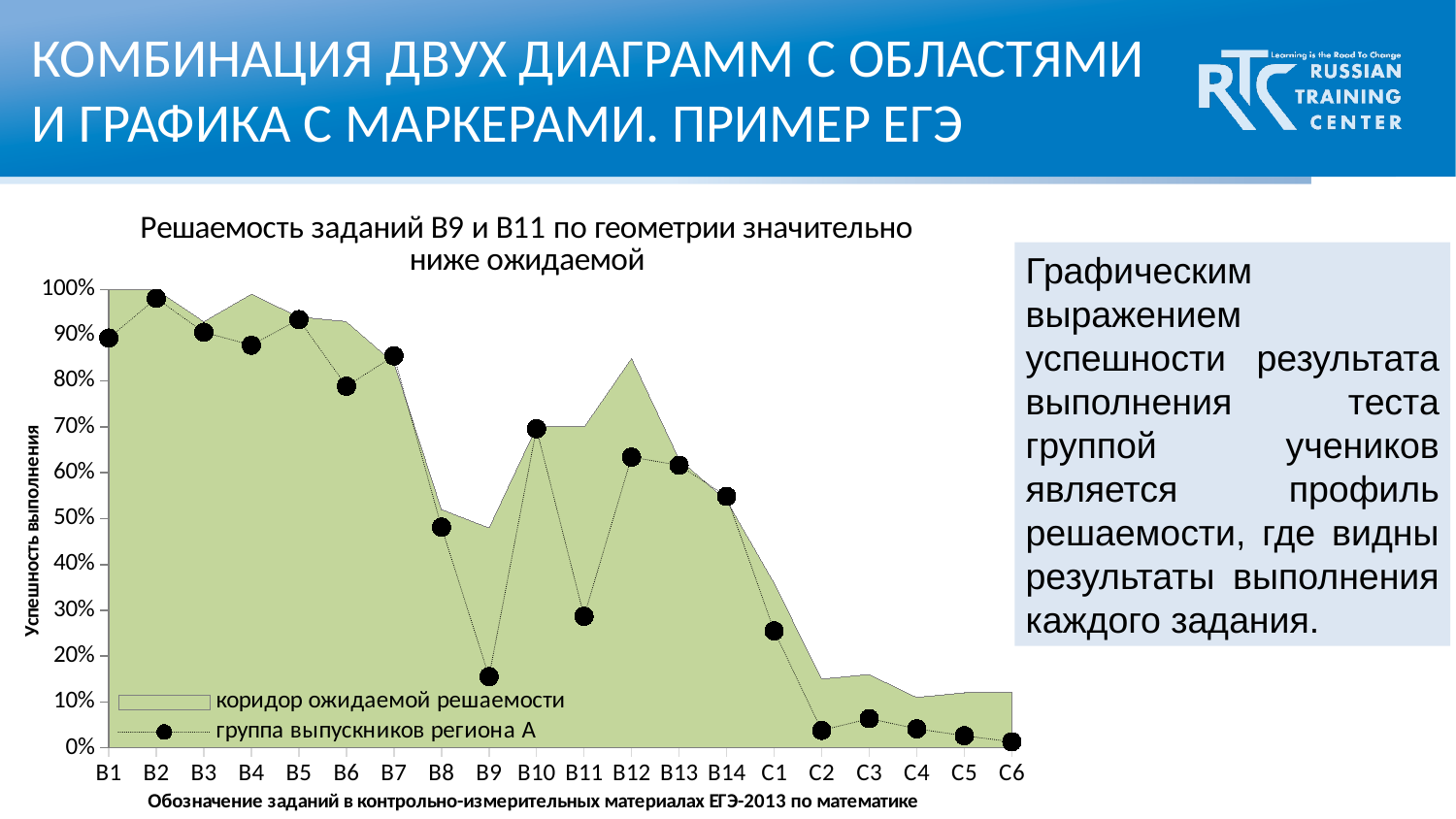
What is the title of the chart? Решаемость заданий В9 и В11 по геометрии значительно ниже ожидаемой Which is larger for 'группа выпускников региона А': the value for В10 or the value for В11? В10 Among the B tasks (В1–В14), which has the lowest value for 'группа выпускников региона А'? В9 What kind of chart is this? A combination of an area chart and a line chart with markers Is the value for В8 in the series 'группа выпускников региона А' greater or less than 50%? less What is the label of the y axis? Успешность выполнения Overall, do the values for 'группа выпускников региона А' rise or fall from В1 to С6? fall How many task categories are shown along the x axis? 20 Is the value for В9 in the series 'группа выпускников региона А' greater or less than 20%? less How many series does the chart legend list? 2 Is the value for В10 in the series 'группа выпускников региона А' greater or less than 60%? greater Which task has the highest value for the series 'группа выпускников региона А'? В2